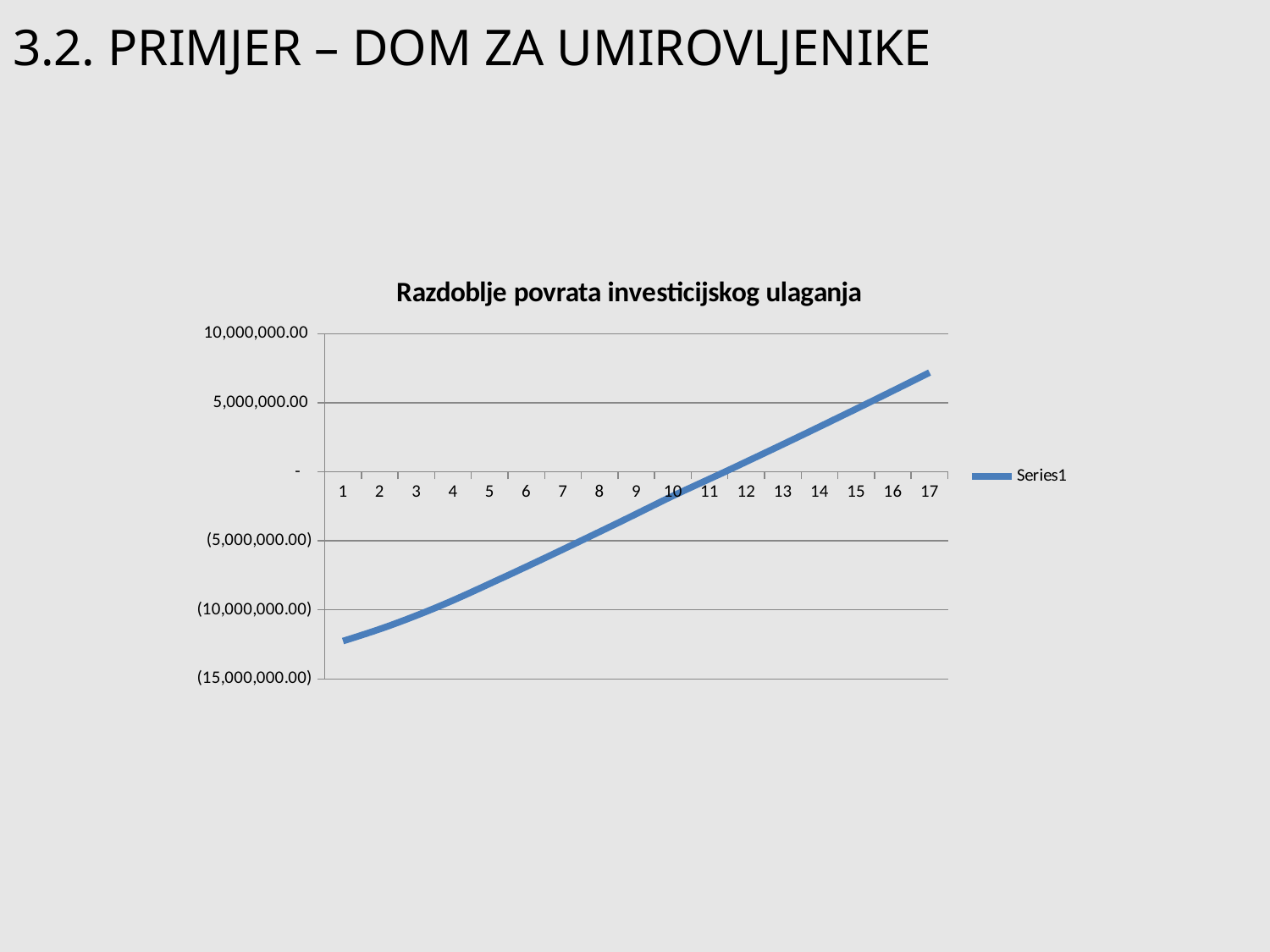
How many points are plotted along the x axis? 17 Is the value at category 17 greater or less than 5,000,000.00? greater Do the values rise or fall as the x axis goes from 1 to 17? rise What is the title of the chart? Razdoblje povrata investicijskog ulaganja Is the value at category 14 greater or less than 5,000,000.00? less Which is larger, the value at category 5 or the value at category 12? category 12 Is the value at category 1 greater or less than (10,000,000.00)? less At which x-axis category is the value highest? 17 What is the name of the series shown in the legend? Series1 At which x-axis category is the value lowest? 1 What kind of chart is shown on the slide? line chart How many series does the legend list? 1